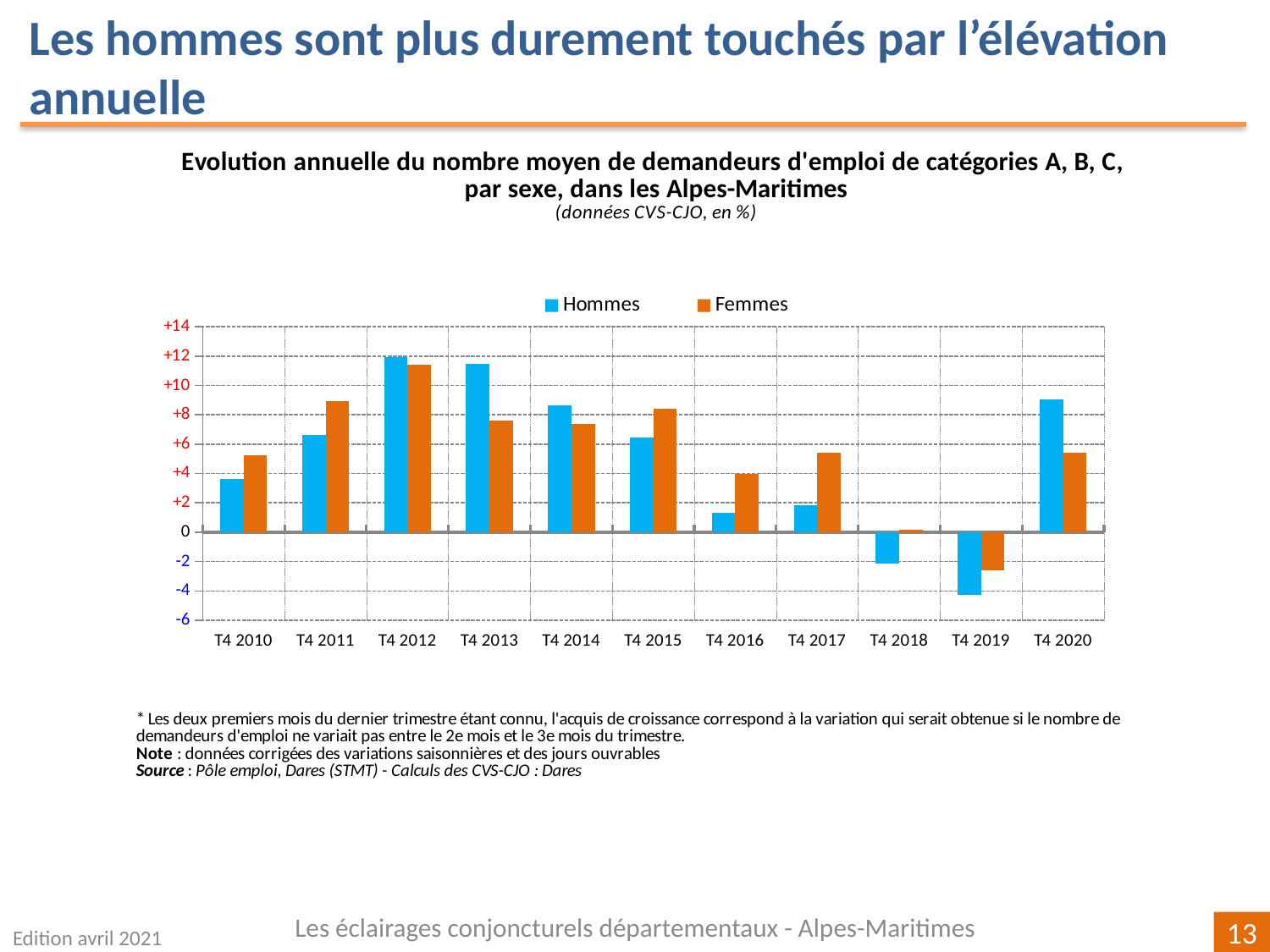
Which colour represents the Hommes series in the legend? blue How many quarters (categories) are shown on the x axis? 11 In which quarter is the Hommes value lowest? T4 2019 In which quarter is the Femmes value lowest? T4 2019 How many series does the legend list? 2 Is the Hommes value for T4 2019 greater or less than -2? less For T4 2017, which series has the larger value, Hommes or Femmes? Femmes Is the Hommes value for T4 2020 greater or less than 8? greater For T4 2013, which series has the larger value, Hommes or Femmes? Hommes Is the Hommes value for T4 2016 greater or less than 2? less What kind of chart is shown on the slide? bar chart In which quarter is the Femmes value highest? T4 2012